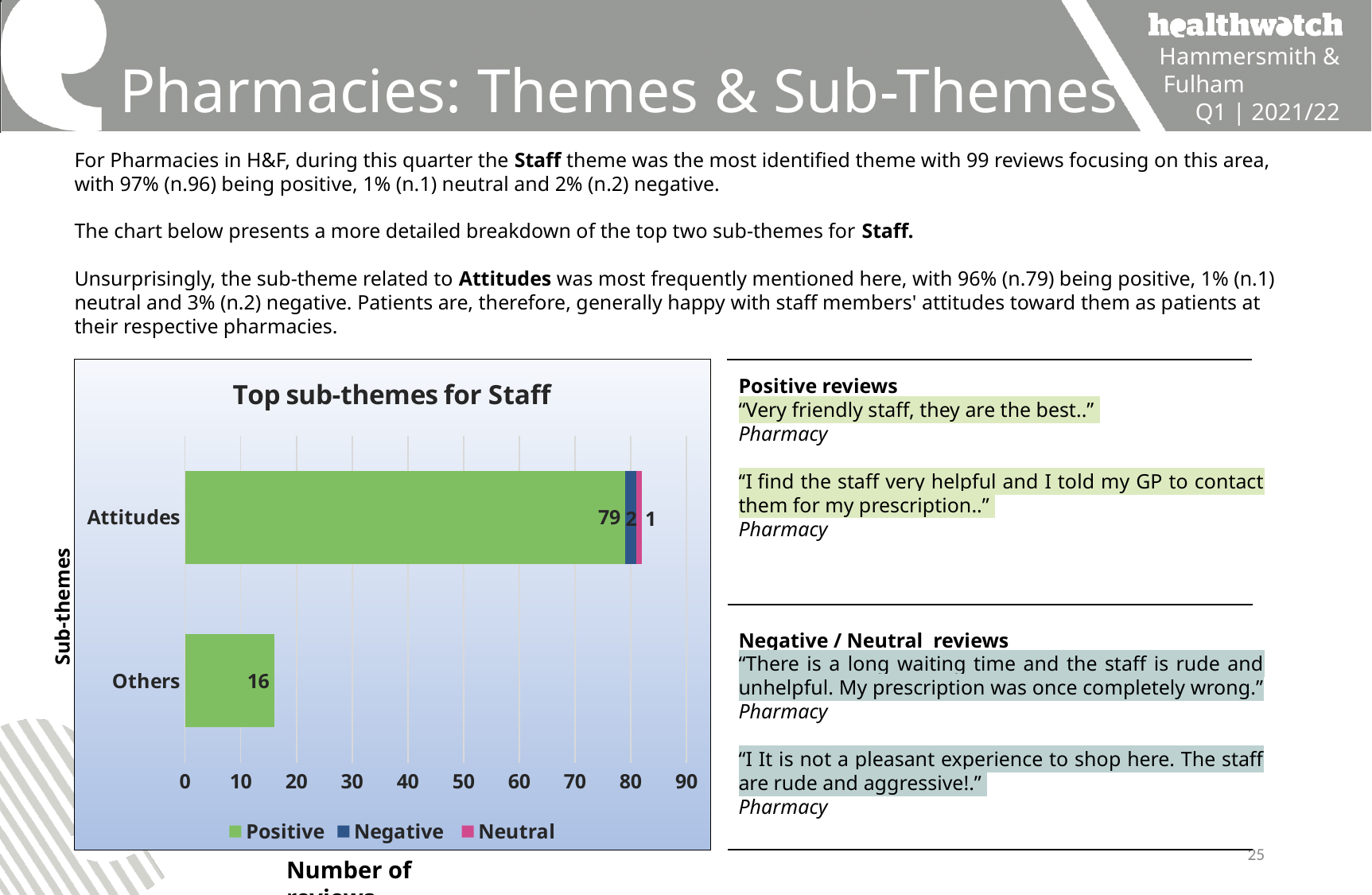
What is the difference between the Positive reviews for Attitudes and for Others? 63 Which sub-theme has the highest number of Positive reviews? Attitudes What is the number of Positive reviews for Attitudes? 79 What is the number of Neutral reviews for Attitudes? 1 How many series does the chart legend list? 3 What is the total number of reviews in the Attitudes bar? 82 Is the Positive value for Others greater or less than 20? less What is the number of Negative reviews for Attitudes? 2 What is the number of Positive reviews for Others? 16 How many sub-theme categories are shown on the chart? 2 What kind of chart is shown on the slide? Stacked bar chart What is the title of the chart? Top sub-themes for Staff